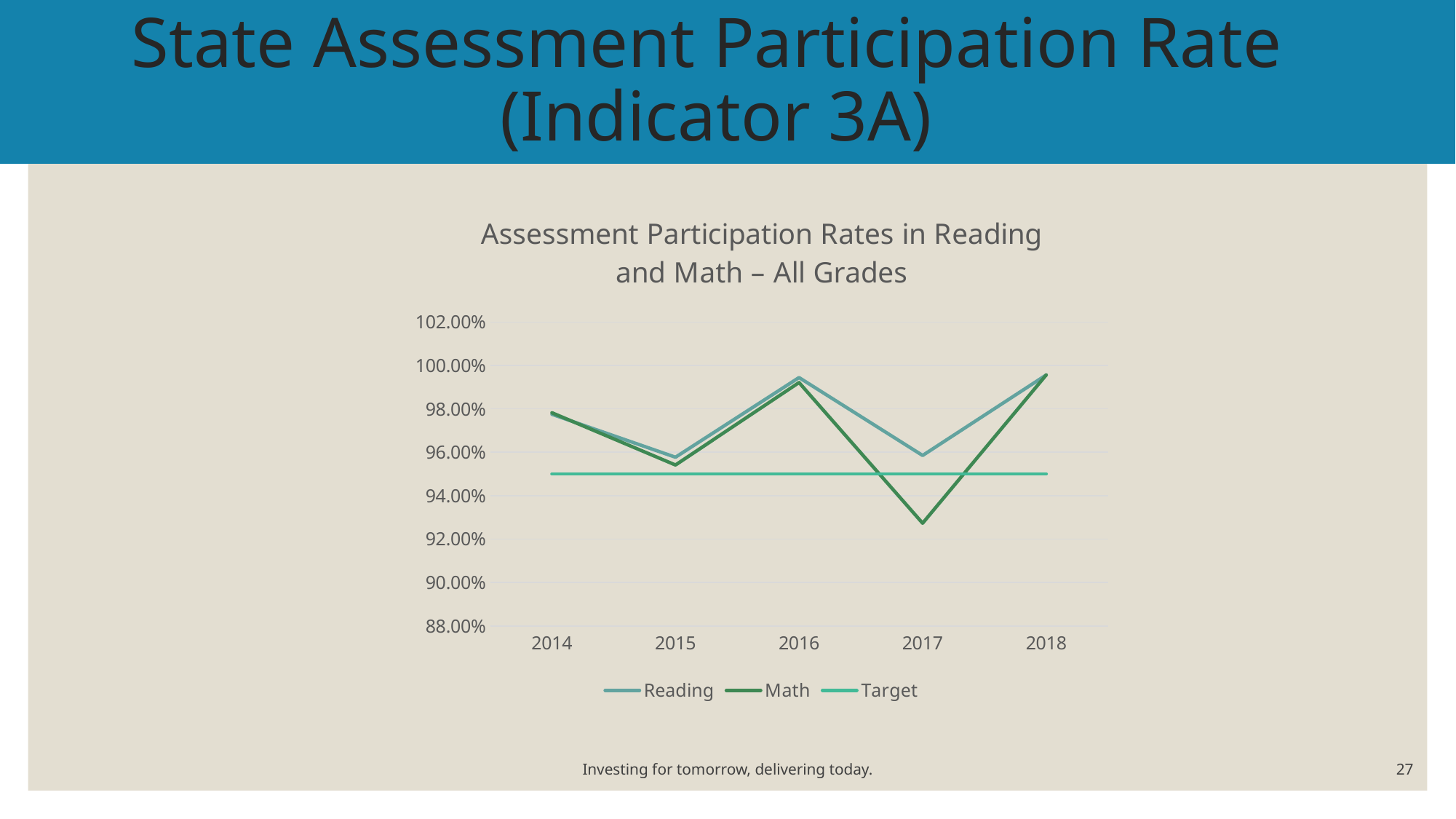
In 2017, which is larger, the Reading rate or the Math rate? Reading Is the Math value for 2018 greater or less than 98.00%? greater Does the Reading line rise or fall from 2017 to 2018? rise Is the Reading value for 2017 greater or less than 94.00%? greater Does the Math line rise or fall from 2016 to 2017? fall What kind of chart is shown on the slide? line chart In which year is the Math participation rate lowest? 2017 What are the three series named in the legend? Reading, Math, Target How many series does the legend list? 3 Is the Math value for 2017 greater or less than 94.00%? less In 2017, is the Math rate above or below the Target line? below How many years are shown on the x axis? 5